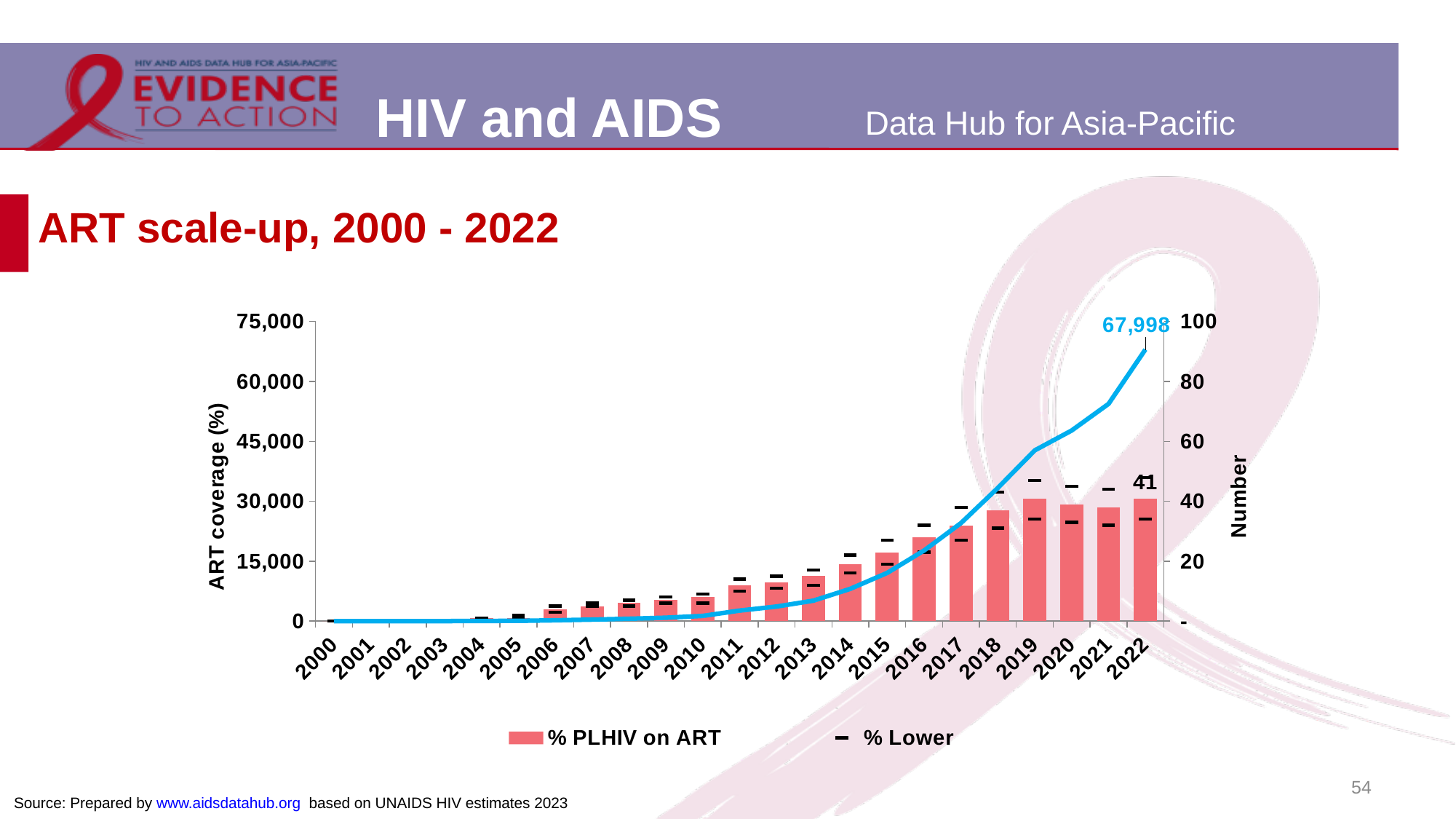
Does the blue line generally rise or fall from 2000 to 2022? rise What is the title of the chart? ART scale-up, 2000 - 2022 Is the bar for 2016 greater or less than 40 on the right axis? less Which year has the higher blue line value, 2017 or 2020? 2020 What value is labelled on the bar for 2022? 41 What value is labelled on the blue line for 2022? 67,998 What are the two entries listed in the legend? % PLHIV on ART and % Lower Is the blue line value for 2021 greater or less than 45,000 on the left axis? greater Is the bar for 2010 greater or less than 20 on the right axis? less How many years are shown along the x axis? 23 Which bar is taller, 2016 or 2018? 2018 Which year has the highest value on the blue line? 2022